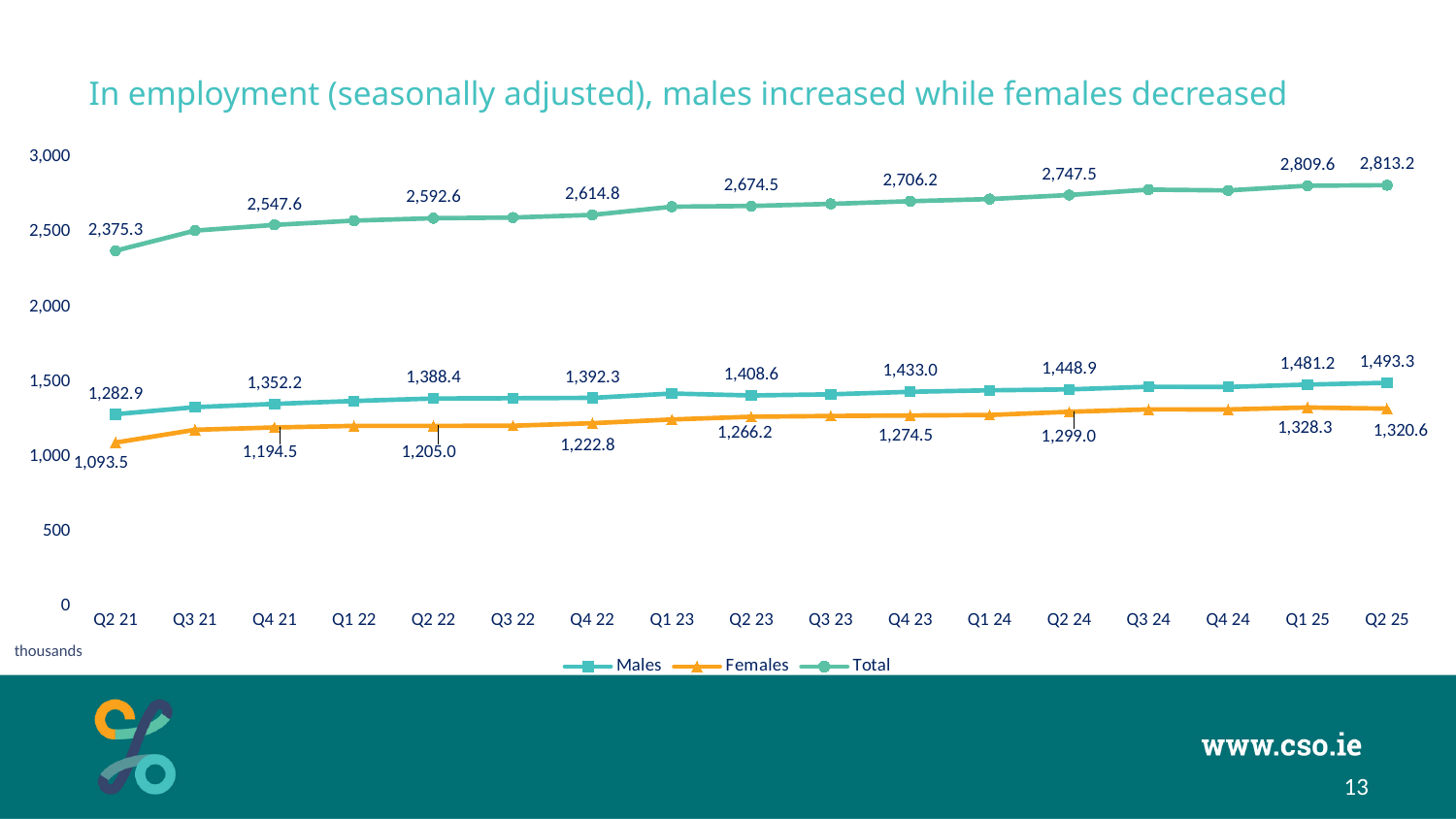
How many series does the legend list? 3 What is the difference between the Males and Females values in Q2 25? 172.7 Which is larger, the Females value in Q1 25 or in Q2 25? Q1 25 What kind of chart is shown on the slide? line chart By how much did the Total value change from Q2 21 to Q2 25? 437.9 Is the Total value for Q3 21 greater or less than 2,000? greater How many quarters are shown on the x axis? 17 What is the Total value for Q2 25? 2,813.2 What is the Males value for Q2 21? 1,282.9 What is the Total value for Q2 24? 2,747.5 What is the Females value for Q4 23? 1,274.5 Does the Total series generally rise or fall from Q2 21 to Q2 25? rise